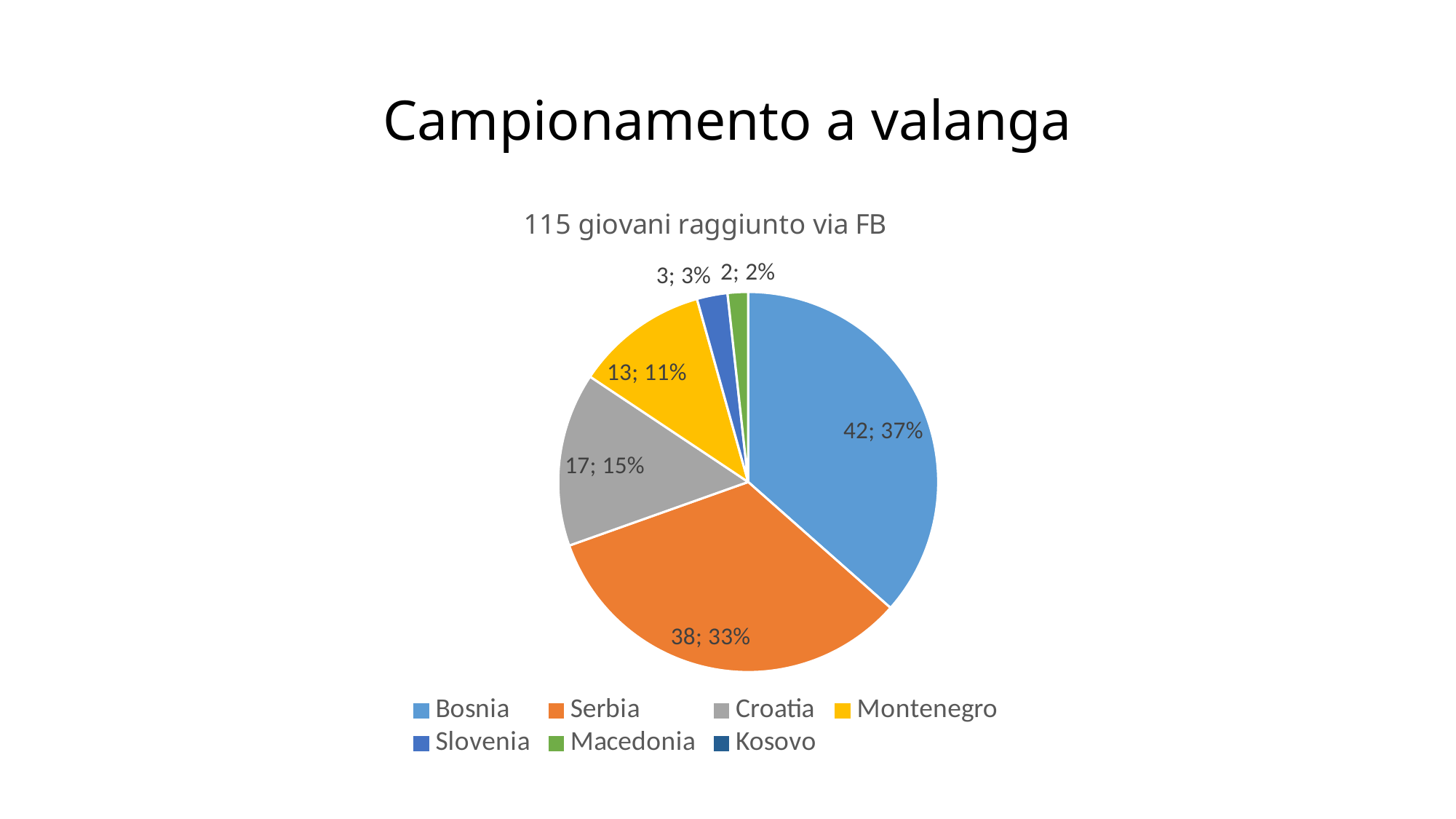
Which country has the largest slice of the pie? Bosnia What percentage share of the pie does Montenegro have? 11% Which country with a visible slice has the smallest share of the pie? Macedonia What is the value for Croatia? 17 What kind of chart is shown on the slide? pie chart What is the value for Bosnia? 42 What is the value for Slovenia? 3 What is the difference between the values for Bosnia and Serbia? 4 Which is larger, the value for Croatia or the value for Montenegro? Croatia What is the title of the chart? 115 giovani raggiunto via FB What percentage share of the pie does Serbia have? 33% How many entries does the chart legend list? 7